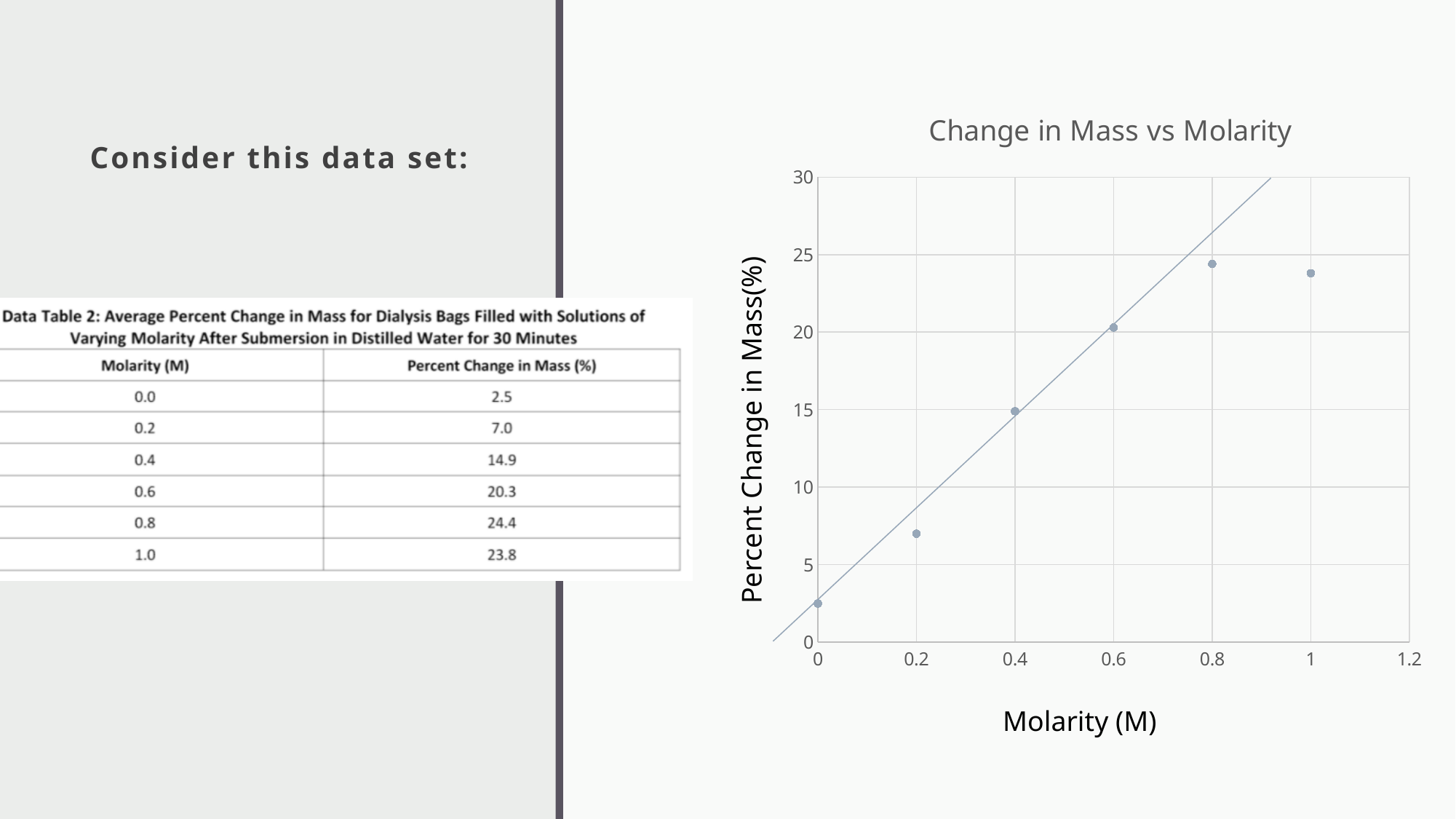
Which has a larger percent change in mass, 0.4 M or 0.6 M? 0.6 M What is the percent change in mass at a molarity of 0.4 M? 14.9 Is the percent change in mass at 0.8 M greater or less than 20? greater How many data points are plotted in the "Change in Mass vs Molarity" chart? 6 What is the difference in percent change in mass between 0.6 M and 0.2 M? 13.3 What is the percent change in mass at a molarity of 1.0 M? 23.8 Does the percent change in mass generally rise or fall as molarity increases from 0 to 0.8 M? rise At which molarity is the percent change in mass lowest? 0.0 What is the label of the y axis in the "Change in Mass vs Molarity" chart? Percent Change in Mass(%) At which molarity is the percent change in mass highest? 0.8 What kind of chart is "Change in Mass vs Molarity"? scatter chart What is the percent change in mass at a molarity of 0.0 M? 2.5